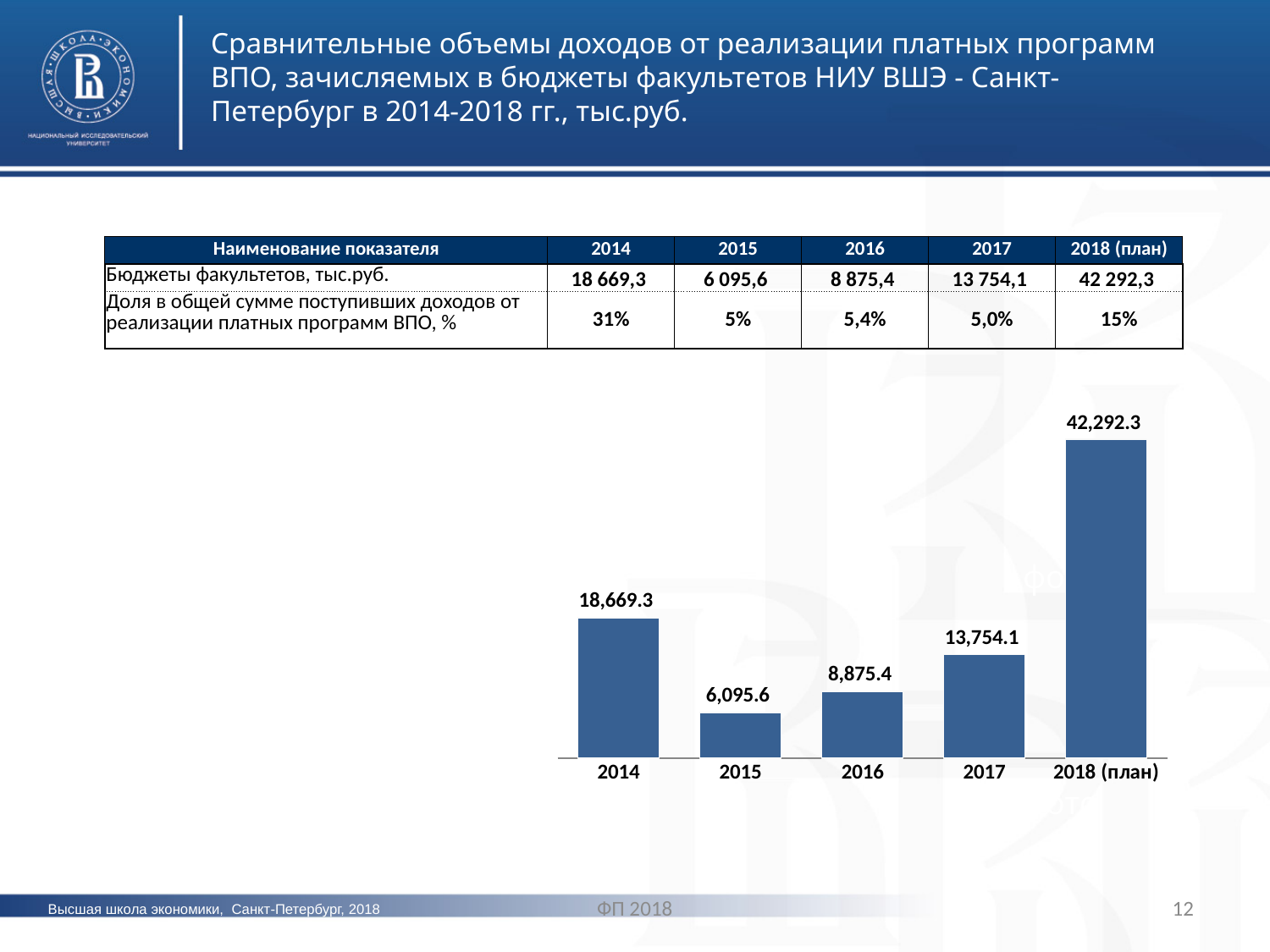
What is the value of the bar for 2015? 6,095.6 How many bars are shown in the chart? 5 Which category has the lowest bar? 2015 What is the difference between the values for 2017 and 2016? 4,878.7 What is the value of the bar for 2017? 13,754.1 What is the value of the bar for 2016? 8,875.4 What is the value of the bar for 2018 (план)? 42,292.3 What is the difference between the values for 2018 (план) and 2014? 23,623.0 What type of chart is shown on the slide? bar chart Which is larger, the value for 2014 or the value for 2017? 2014 What is the value of the bar for 2014? 18,669.3 Which category has the highest bar? 2018 (план)